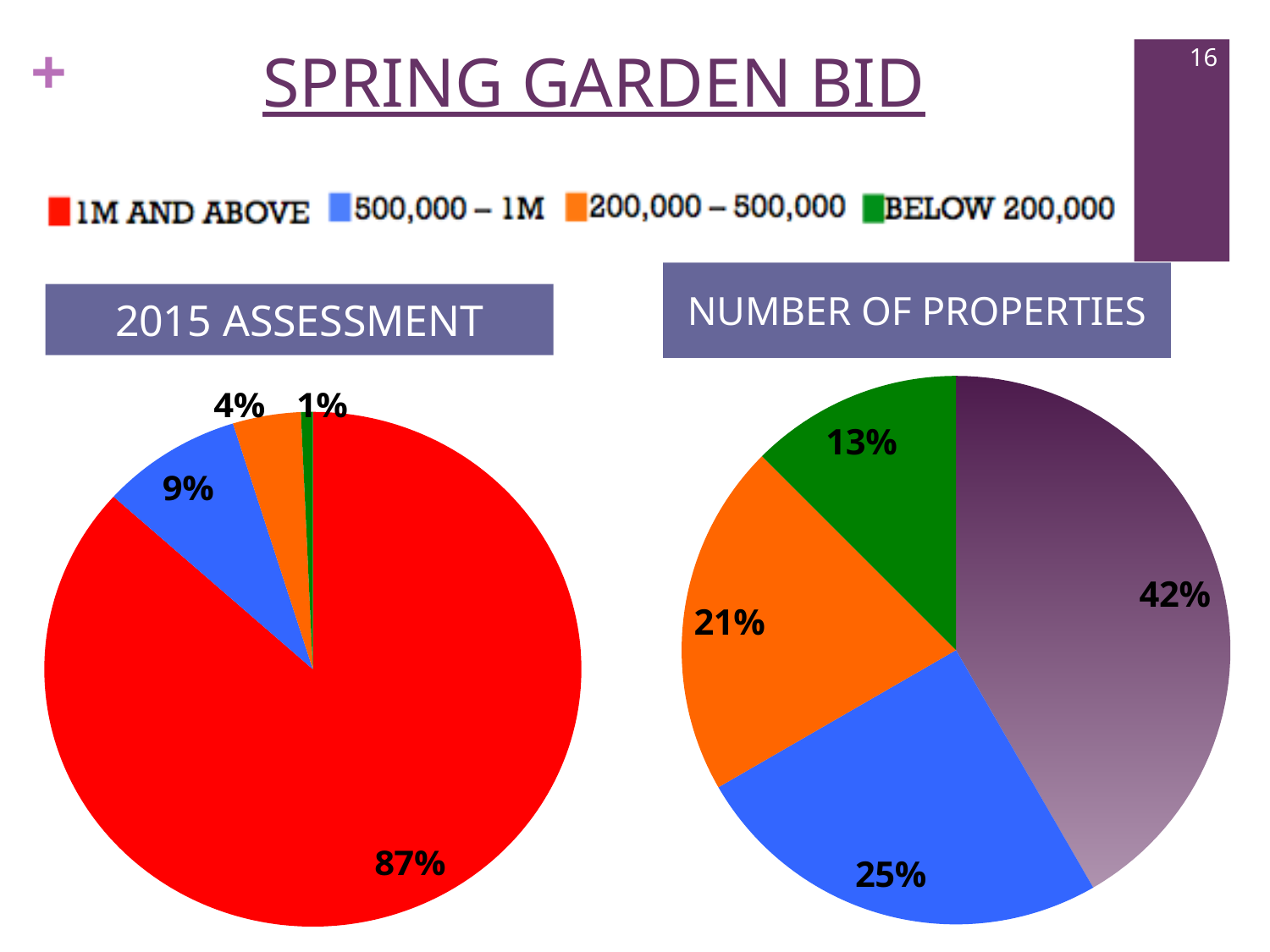
In the NUMBER OF PROPERTIES chart, what is the share of the largest slice? 42% What kind of chart is the 2015 ASSESSMENT chart? pie chart In the NUMBER OF PROPERTIES chart, what share is shown for BELOW 200,000? 13% In the 2015 ASSESSMENT chart, which category has the smallest slice? BELOW 200,000 In the NUMBER OF PROPERTIES chart, what share is shown for 500,000 – 1M? 25% How many categories does the legend list? 4 In the 2015 ASSESSMENT chart, what is the difference between the 500,000 – 1M share and the 200,000 – 500,000 share? 5% In the NUMBER OF PROPERTIES chart, which is larger: the 500,000 – 1M slice or the BELOW 200,000 slice? 500,000 – 1M In the 2015 ASSESSMENT chart, what share is shown for 500,000 – 1M? 9%